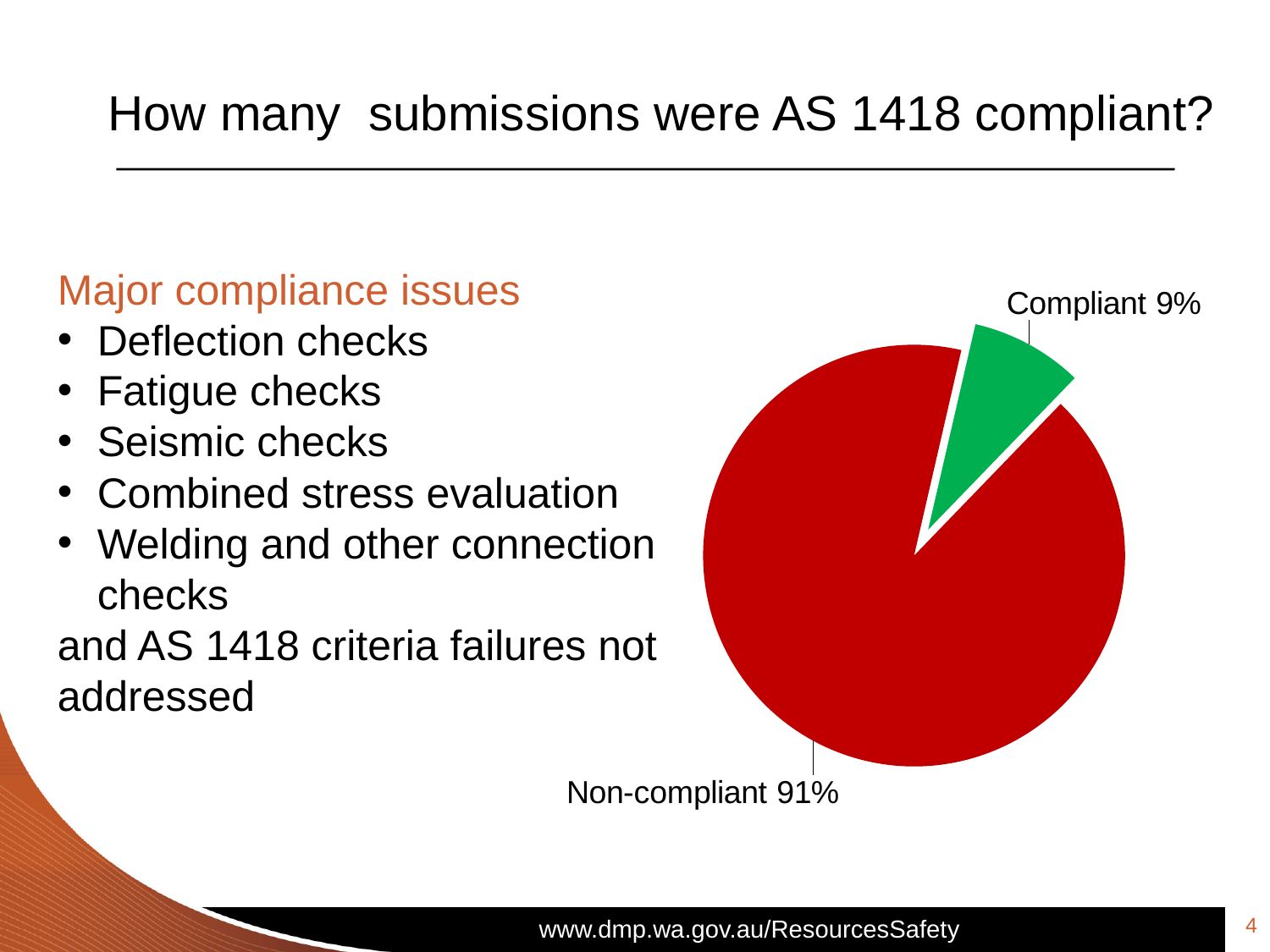
What percentage of submissions were Compliant? 9% What share of the pie does the Compliant slice represent? 9% What percentage of submissions were Non-compliant? 91% What colour is the Compliant slice? green What kind of chart is shown on the slide? pie chart Which slice of the pie is the smallest? Compliant How many slices does the pie chart have? 2 What is the difference in percentage points between the Non-compliant and Compliant slices? 82 What colour is the Non-compliant slice? red Which slice of the pie is the largest? Non-compliant Which is larger, the Compliant slice or the Non-compliant slice? Non-compliant